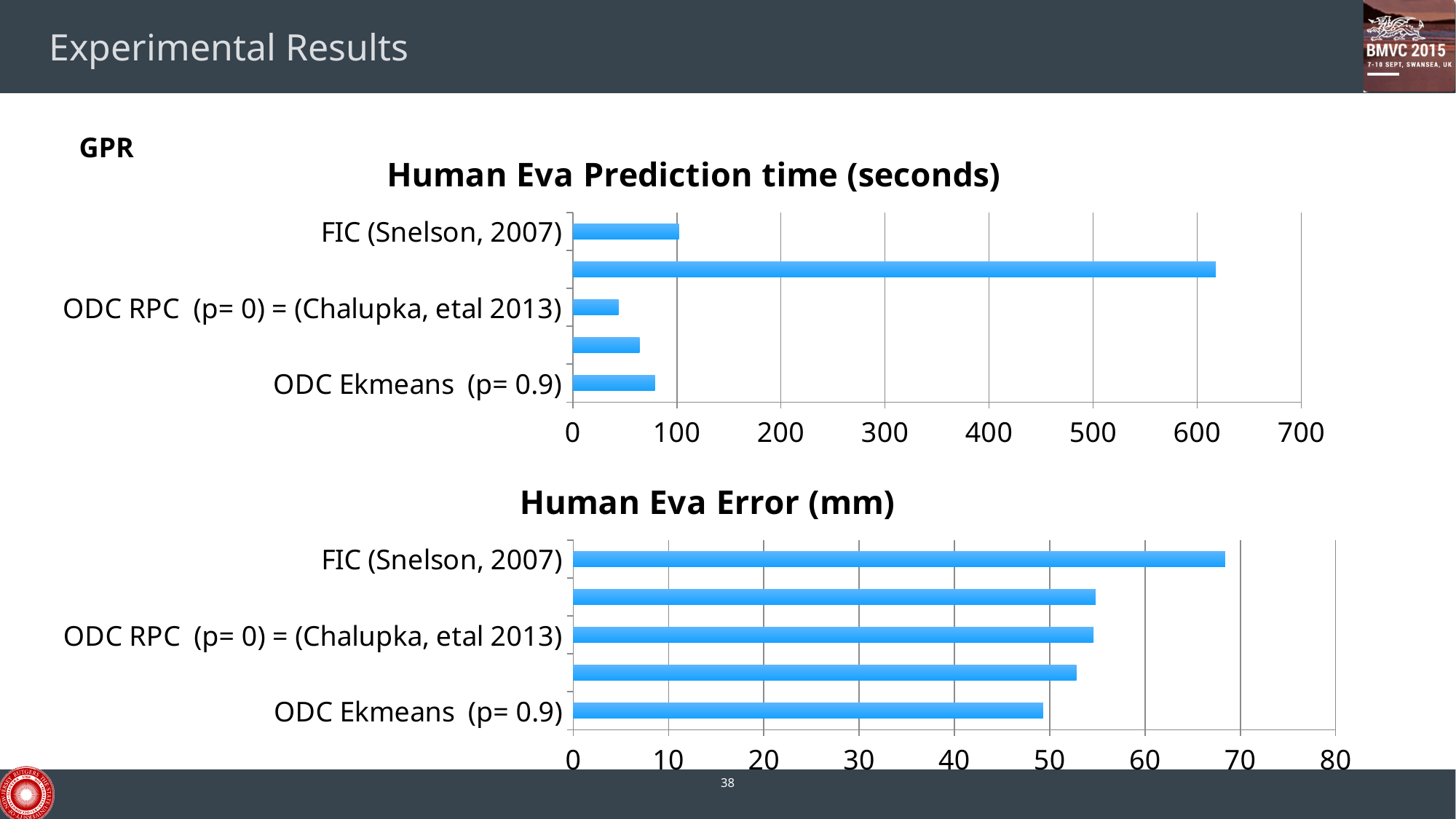
In the "Human Eva Error (mm)" chart, which of the labelled methods has the lowest error? ODC Ekmeans (p= 0.9) In the "Human Eva Prediction time (seconds)" chart, is the value for FIC (Snelson, 2007) greater or less than 200? less What is the title of the top chart on the slide? Human Eva Prediction time (seconds) In the "Human Eva Prediction time (seconds)" chart, which of the labelled methods has the lowest prediction time? ODC RPC (p= 0) = (Chalupka, etal 2013) How many bars are plotted in the "Human Eva Error (mm)" chart? 5 In the "Human Eva Prediction time (seconds)" chart, is the value for ODC RPC (p= 0) = (Chalupka, etal 2013) greater or less than 100? less In the "Human Eva Error (mm)" chart, which has the larger error: FIC (Snelson, 2007) or ODC Ekmeans (p= 0.9)? FIC (Snelson, 2007) What kind of chart is the "Human Eva Prediction time (seconds)" chart? bar chart In the "Human Eva Prediction time (seconds)" chart, is the value for ODC Ekmeans (p= 0.9) greater or less than 100? less In the "Human Eva Prediction time (seconds)" chart, which of the labelled methods has the highest prediction time? FIC (Snelson, 2007)